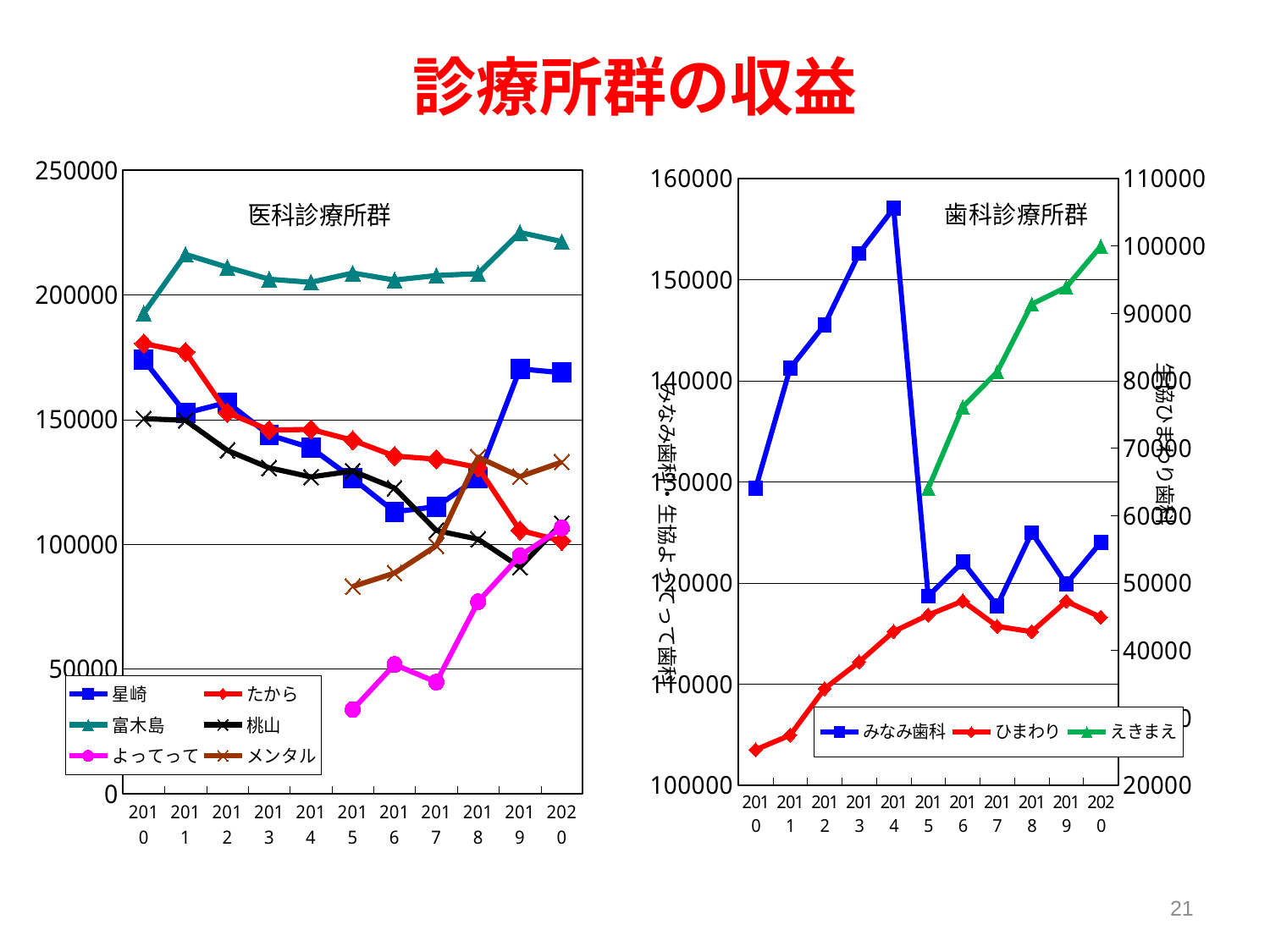
How many years are shown on the x axis of the 医科診療所群 chart? 11 In the 医科診療所群 chart, does the よってって series rise or fall from 2015 to 2020? rise In the 歯科診療所群 chart, in which year does the えきまえ series begin? 2015 In the 医科診療所群 chart, which series has the lowest value in 2010? 桃山 In the 医科診療所群 chart, is the value for よってって in 2015 greater or less than 50000? less In the 医科診療所群 chart, which series has the highest value in 2020? 富木島 What kind of chart is the 医科診療所群 chart on the left? line chart In the 医科診療所群 chart, is the value for 富木島 in 2019 greater or less than 200000? greater In the 歯科診療所群 chart, in which year does みなみ歯科 reach its highest value? 2014 How many series does the legend of the 歯科診療所群 chart list? 3 How many series does the legend of the 医科診療所群 chart list? 6 In the 医科診療所群 chart, which is larger in 2020, 星崎 or たから? 星崎